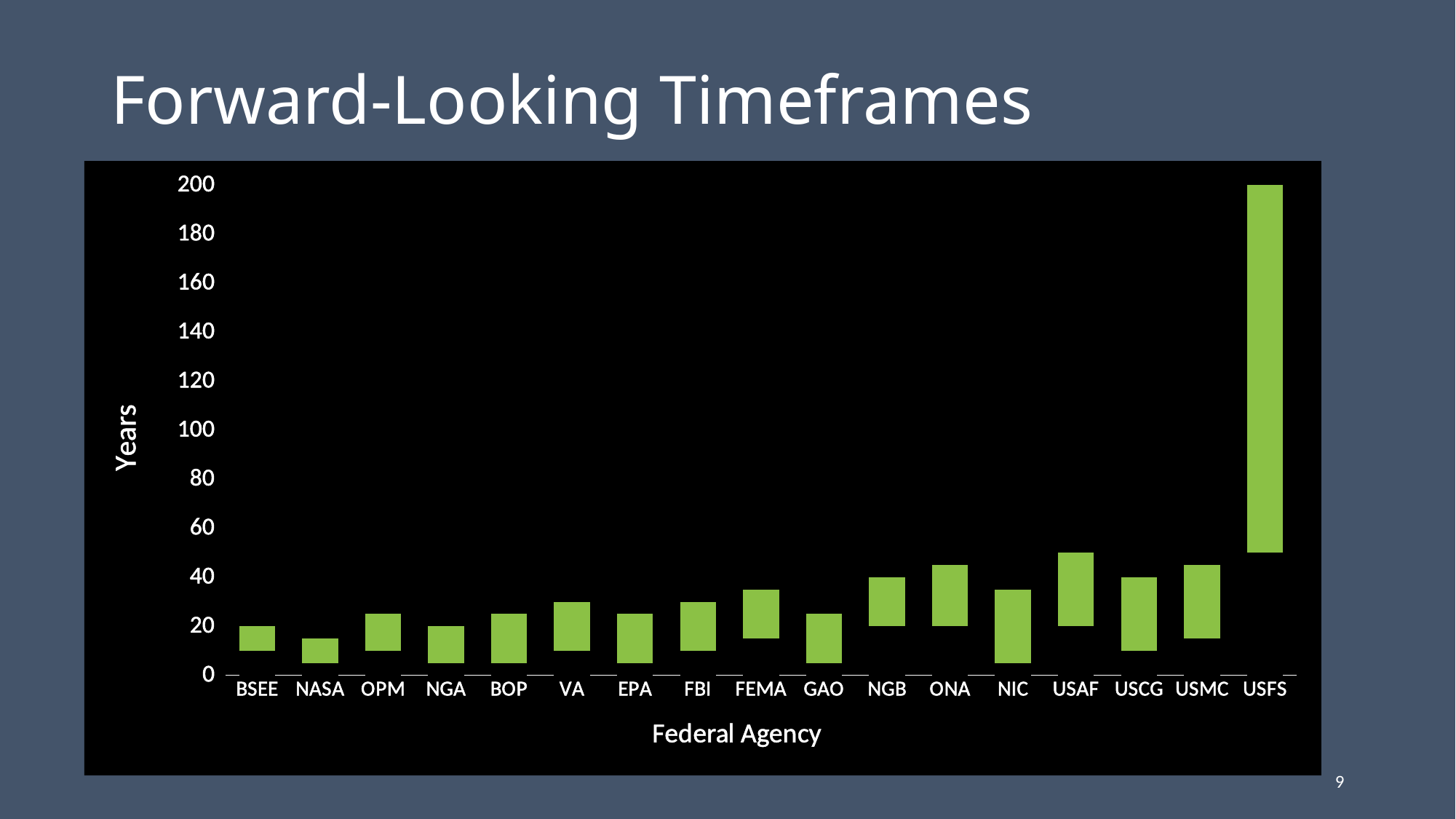
Which federal agency has the highest bar? USFS Is the top of the USAF bar greater or less than 40 years? greater Is the top of the USFS bar greater or less than 100 years? greater Which bar reaches higher, ONA or NASA? ONA What is the label of the horizontal axis? Federal Agency What is the label of the vertical axis? Years How many federal agencies are shown on the x axis? 17 What kind of chart is shown on the slide? bar chart Which federal agency has the lowest bar? NASA Which bar reaches higher, USFS or BSEE? USFS What value does the top of the USFS bar reach on the Years axis? 200 Is the top of the NASA bar greater or less than 20 years? less